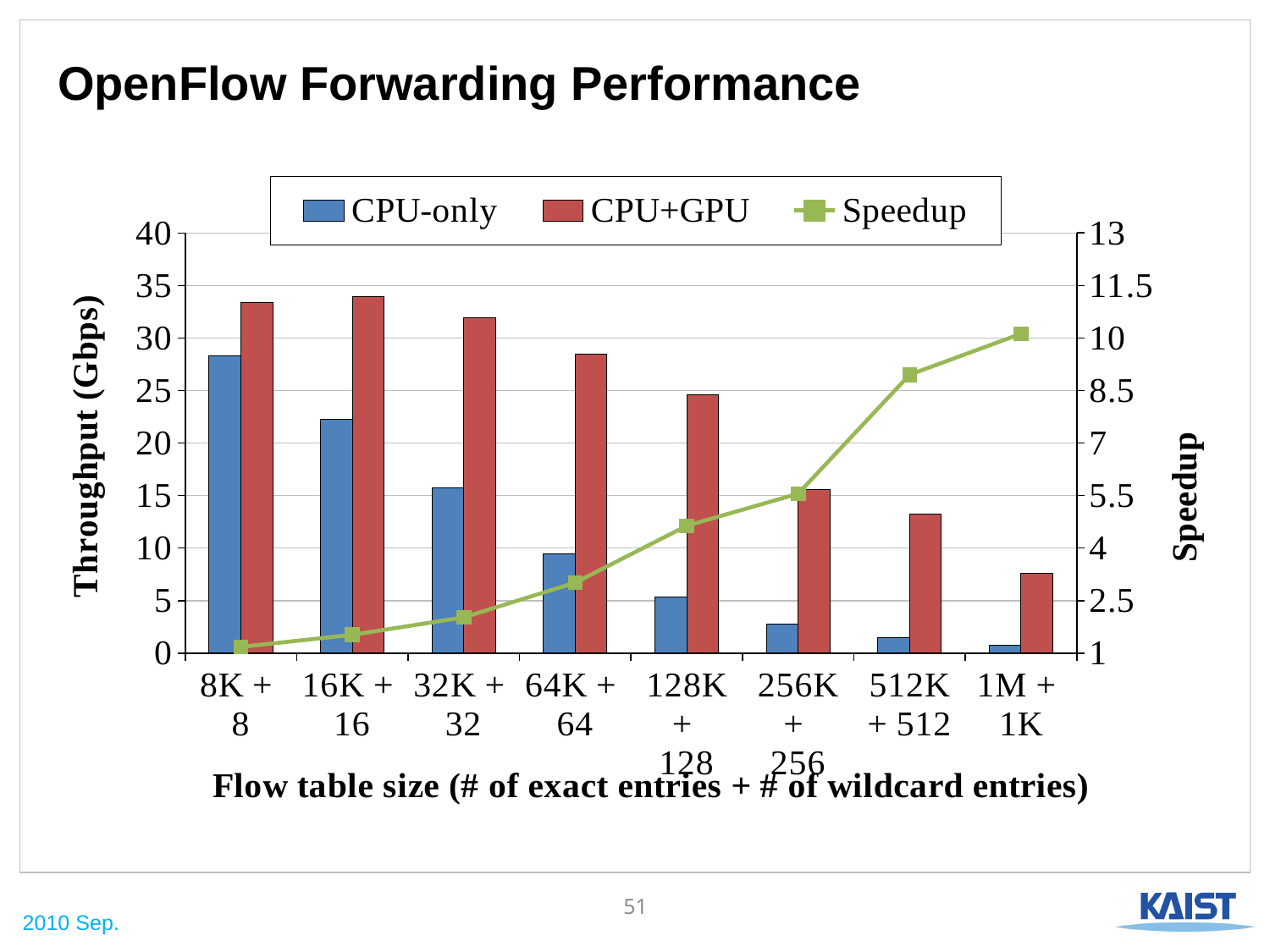
Is the CPU-only throughput for 8K + 8 greater or less than 25 Gbps? greater What kind of chart is this? Combined bar and line chart Which flow table size has the highest CPU-only throughput? 8K + 8 Which is larger for 256K + 256: the CPU-only throughput or the CPU+GPU throughput? CPU+GPU How many series does the legend list? 3 Which flow table size has the lowest CPU+GPU throughput? 1M + 1K How many flow table size categories are shown on the x axis? 8 Is the Speedup for 512K + 512 greater or less than 7? greater Is the CPU+GPU throughput for 64K + 64 greater or less than 25 Gbps? greater Which flow table size has the lowest CPU-only throughput? 1M + 1K Does the Speedup rise or fall as the flow table size increases along the x axis? rises